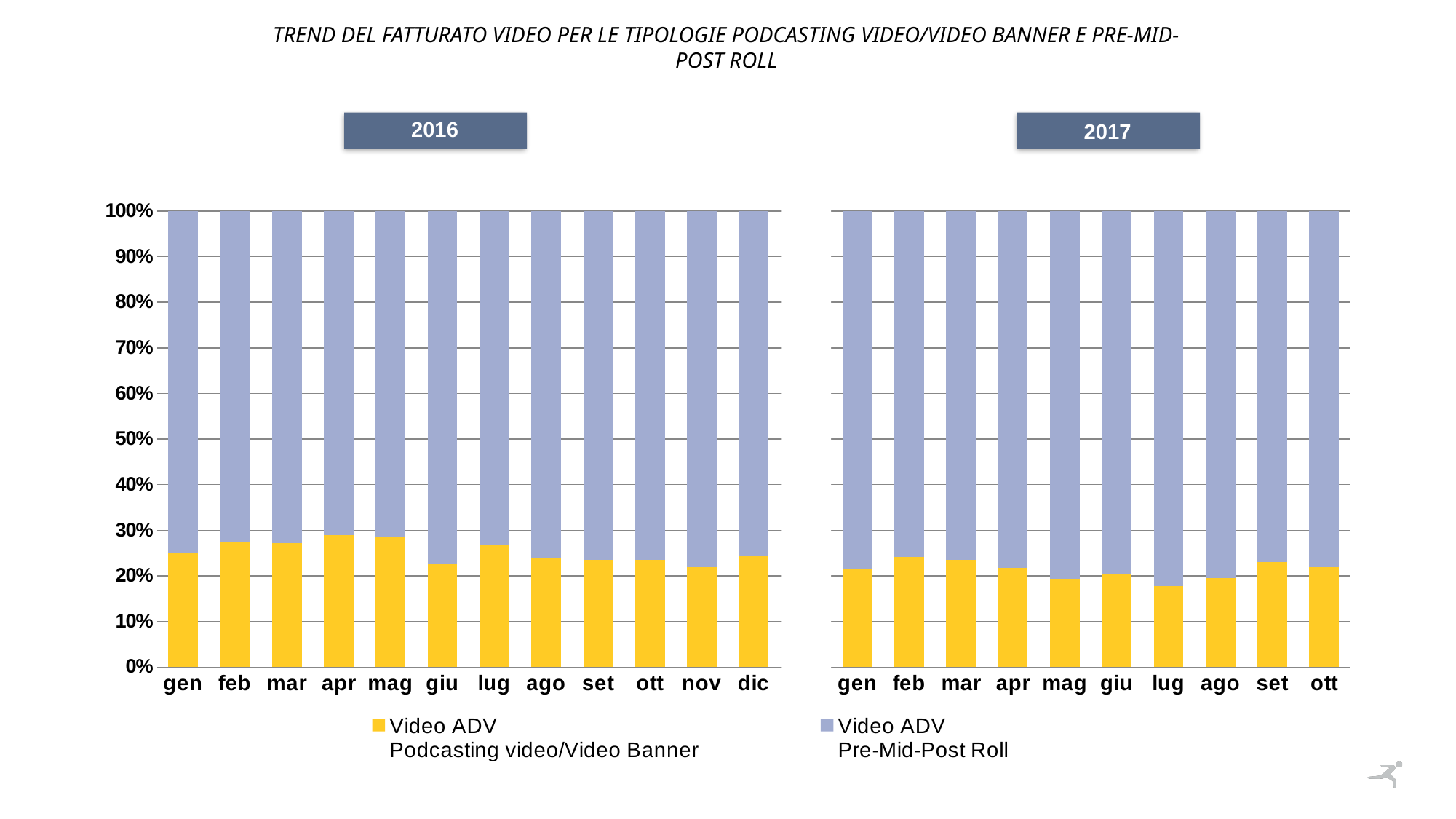
On the 2017 chart, which is larger for Video ADV Podcasting video/Video Banner: feb or lug? feb How many months are shown on the 2017 chart? 10 Which series is shown in yellow on the charts? Video ADV Podcasting video/Video Banner What kind of chart is the 2016 chart? stacked bar chart On the 2016 chart, is the Video ADV Podcasting video/Video Banner share for giu greater or less than 30%? less How many months are shown on the 2016 chart? 12 On the 2017 chart, which month has the lowest share for Video ADV Podcasting video/Video Banner? lug On the 2017 chart, is the Video ADV Podcasting video/Video Banner share for lug greater or less than 20%? less What is the top value shown on the y axis of the charts? 100% On the 2016 chart, which is larger for Video ADV Podcasting video/Video Banner: apr or giu? apr On the 2016 chart, is the Video ADV Podcasting video/Video Banner share for apr greater or less than 20%? greater How many series does the legend list? 2